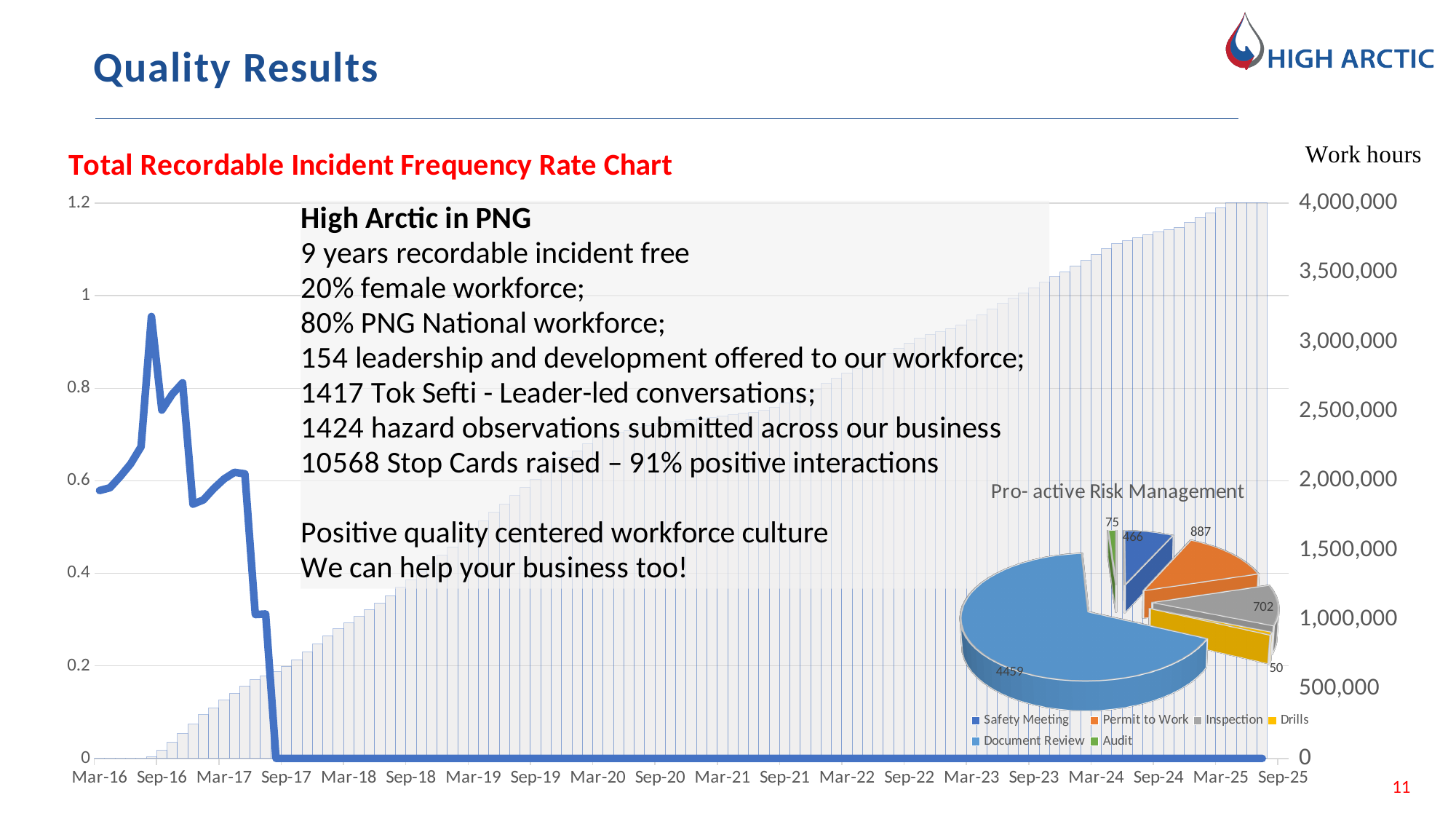
In the Pro- active Risk Management pie chart, which category has the smallest value? Drills What kind of chart is the Pro- active Risk Management chart? Pie chart In the Pro- active Risk Management pie chart, what is the value for Permit to Work? 887 In the Pro- active Risk Management pie chart, what is the value for Inspection? 702 In the Total Recordable Incident Frequency Rate Chart, do the work hours bars rise or fall from Mar-16 to Sep-25? rise In the Pro- active Risk Management pie chart, what is the value for Document Review? 4459 In the Pro- active Risk Management pie chart, which category has the largest value? Document Review In the Pro- active Risk Management pie chart, which is larger: Safety Meeting or Audit? Safety Meeting In the Pro- active Risk Management pie chart, what is the difference between Permit to Work and Inspection? 185 How many entries does the legend of the Pro- active Risk Management chart list? 6